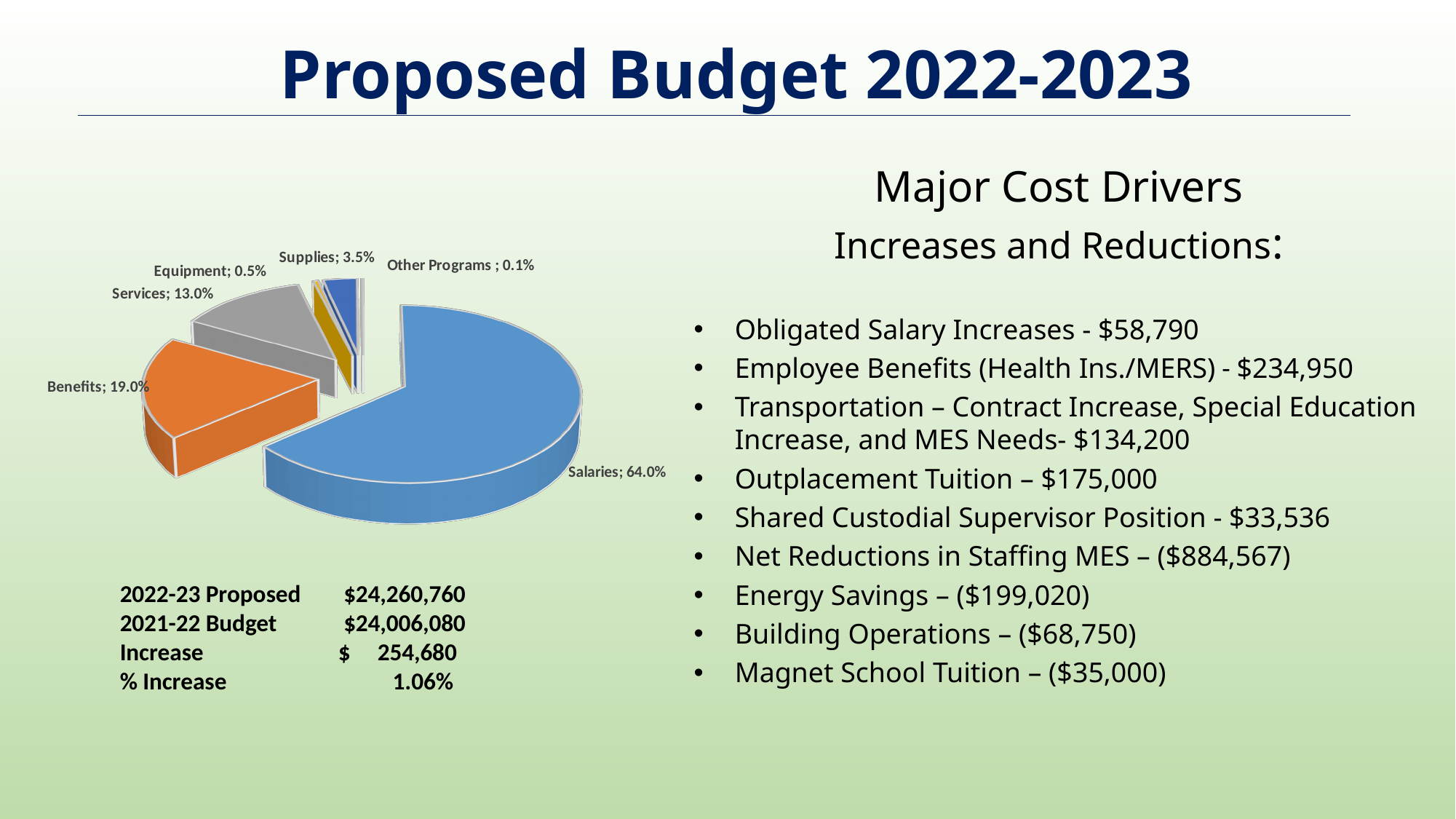
What share of the pie chart is Benefits? 19.0% What is the difference in percentage points between the Salaries and Benefits slices? 45.0% What share of the pie chart is Services? 13.0% Which slice is larger, Services or Supplies? Services What share of the pie chart is Equipment? 0.5% How many categories are shown in the pie chart? 6 Which category has the smallest slice of the pie chart? Other Programs What kind of chart is shown on the slide? Pie chart Which category has the largest slice of the pie chart? Salaries